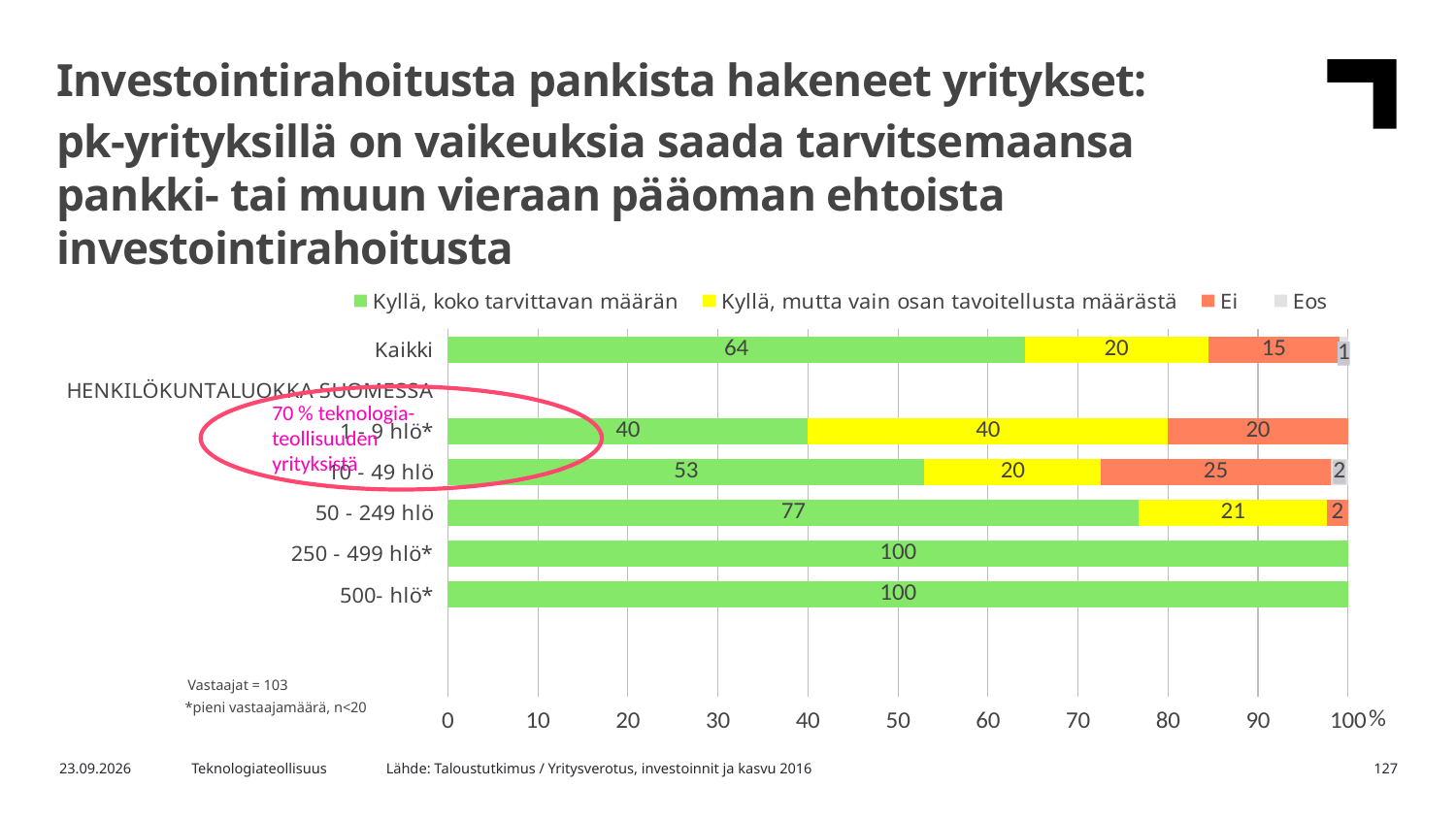
What is the value of 'Kyllä, koko tarvittavan määrän' for 50 - 249 hlö? 77 What is the value of 'Kyllä, koko tarvittavan määrän' for Kaikki? 64 Which category has the lowest value for 'Kyllä, koko tarvittavan määrän'? 1 - 9 hlö* What is the value of 'Kyllä, koko tarvittavan määrän' for 250 - 499 hlö*? 100 What is the value of 'Ei' for 10 - 49 hlö? 25 How many series does the legend list? 4 What is the difference between the 'Kyllä, koko tarvittavan määrän' values for 50 - 249 hlö and 10 - 49 hlö? 24 Which category has the highest value for 'Ei'? 10 - 49 hlö What is the value of 'Kyllä, mutta vain osan tavoitellusta määrästä' for 1 - 9 hlö*? 40 How many categories are plotted on the y axis? 6 Which is larger: the 'Ei' value for Kaikki or the 'Ei' value for 1 - 9 hlö*? 1 - 9 hlö* What kind of chart is shown on the slide? Stacked bar chart